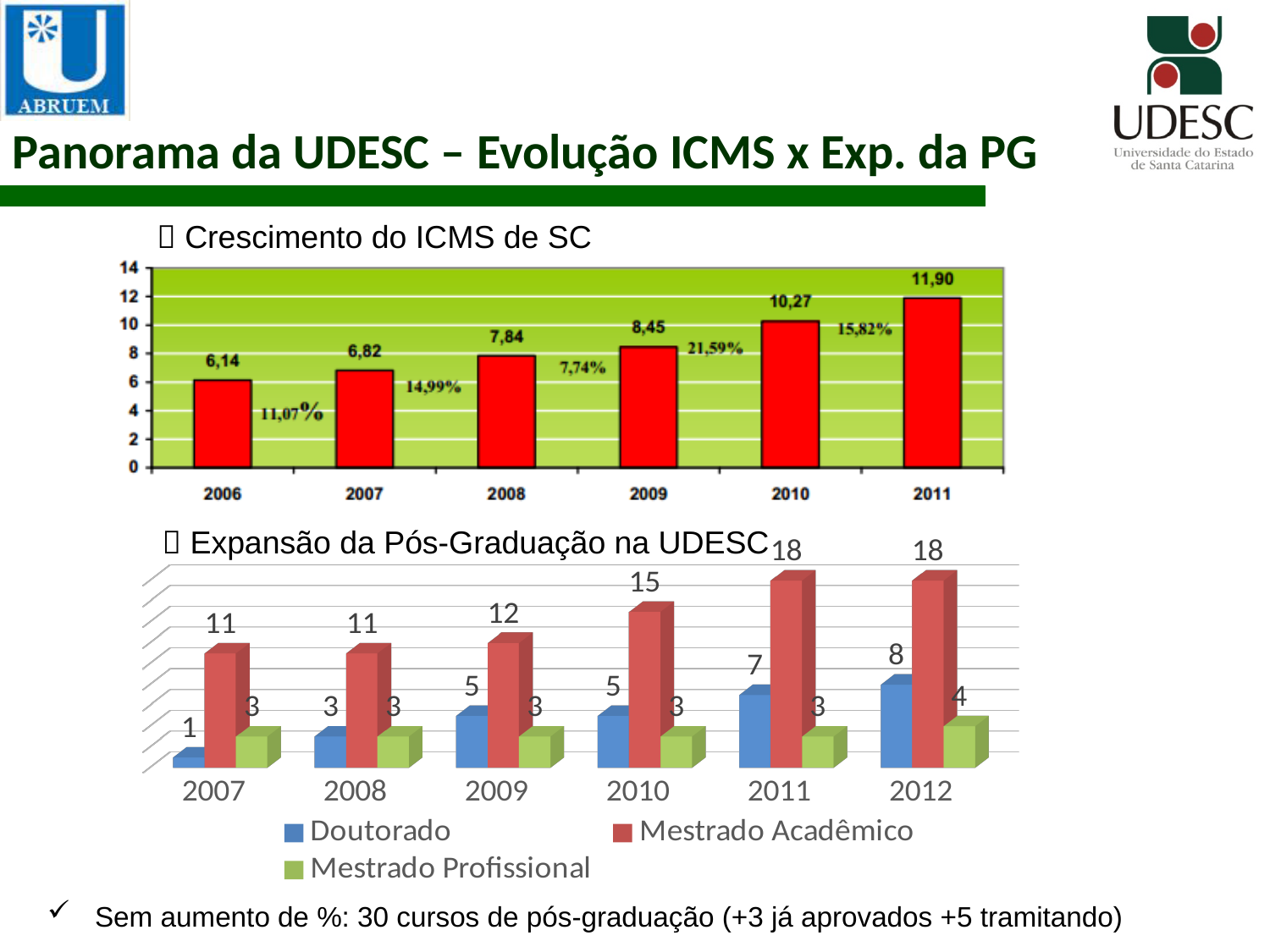
In the 'Crescimento do ICMS de SC' chart, how many years are shown on the x axis? 6 In the 'Crescimento do ICMS de SC' chart, which year has the lowest value? 2006 In the 'Expansão da Pós-Graduação na UDESC' chart, how many series does the legend list? 3 In the 'Expansão da Pós-Graduação na UDESC' chart, what is the value for Mestrado Acadêmico in 2010? 15 In the 'Expansão da Pós-Graduação na UDESC' chart, which is larger in 2012: Doutorado or Mestrado Profissional? Doutorado In the 'Crescimento do ICMS de SC' chart, do the values rise or fall from 2006 to 2011? rise In the 'Crescimento do ICMS de SC' chart, which year has the highest value? 2011 In the 'Crescimento do ICMS de SC' chart, what is the difference between the values for 2011 and 2010? 1,63 In the 'Crescimento do ICMS de SC' chart, what is the value for 2008? 7,84 In the 'Expansão da Pós-Graduação na UDESC' chart, what is the value for Doutorado in 2011? 7 In the 'Expansão da Pós-Graduação na UDESC' chart, what is the difference between Mestrado Acadêmico and Doutorado in 2009? 7 What kind of chart is the 'Expansão da Pós-Graduação na UDESC' chart? bar chart